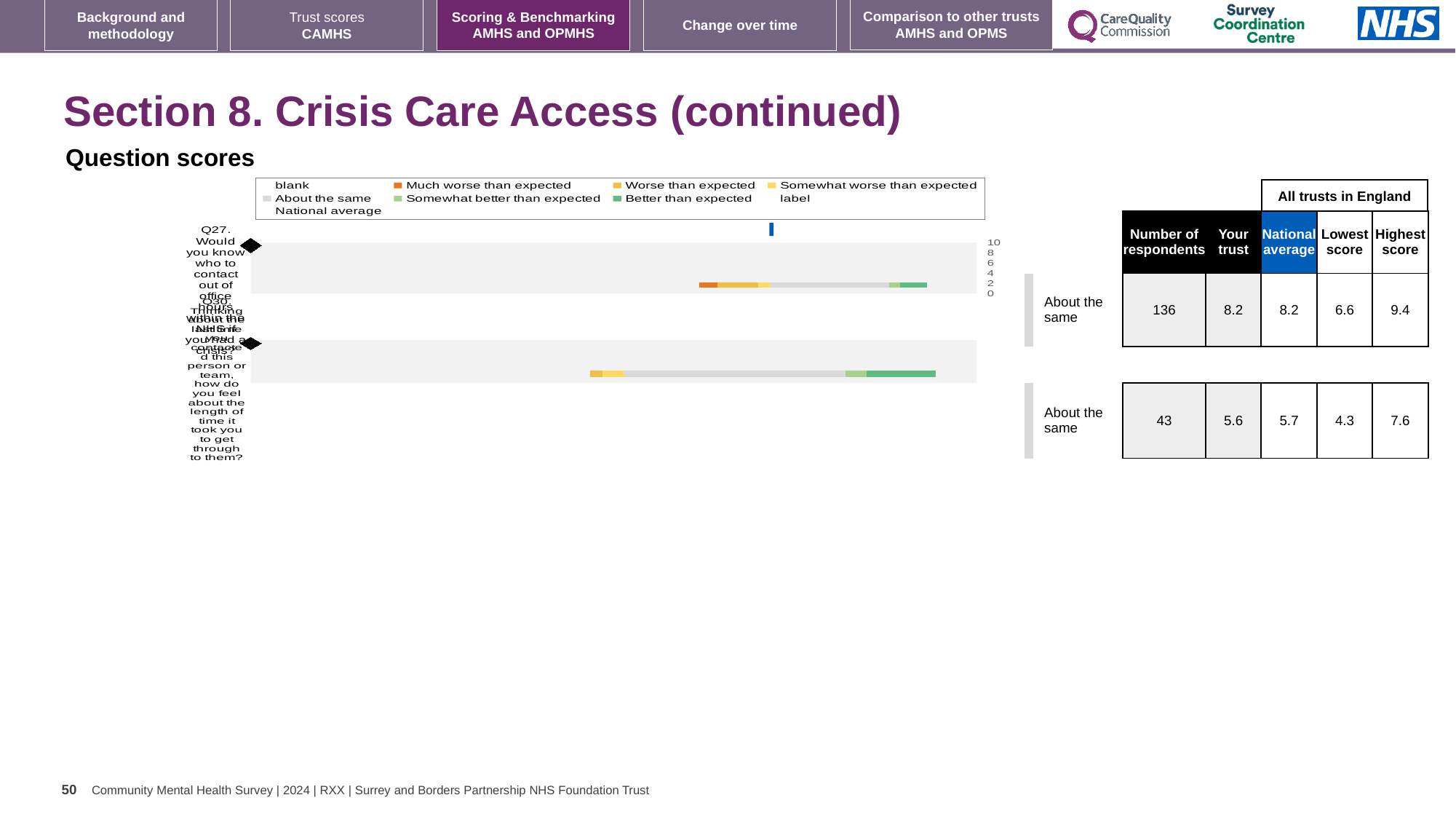
In the legend of the Question scores chart, which entry is shown in orange? Much worse than expected In the table beside the chart, what is the difference between the highest score (9.4) and the lowest score (6.6) for Q27? 2.8 According to the table beside the chart, which question had more respondents, Q27 or Q30? Q27 What kind of chart is shown under the heading "Question scores"? bar chart How many questions (categories) are plotted in the Question scores chart? 2 How many entries does the legend of the Question scores chart list? 9 In the table beside the chart, what is the number of respondents for Q27? 136 In the table beside the chart, what is the "Your trust" score for Q30? 5.6 In the table beside the chart, what is the highest score among all trusts in England for Q30? 7.6 In the table beside the chart, what is the national average score for Q27? 8.2 What is the first entry listed in the legend of the Question scores chart? blank According to the table beside the chart, is the "Your trust" score for Q30 higher or lower than the national average for Q30? lower